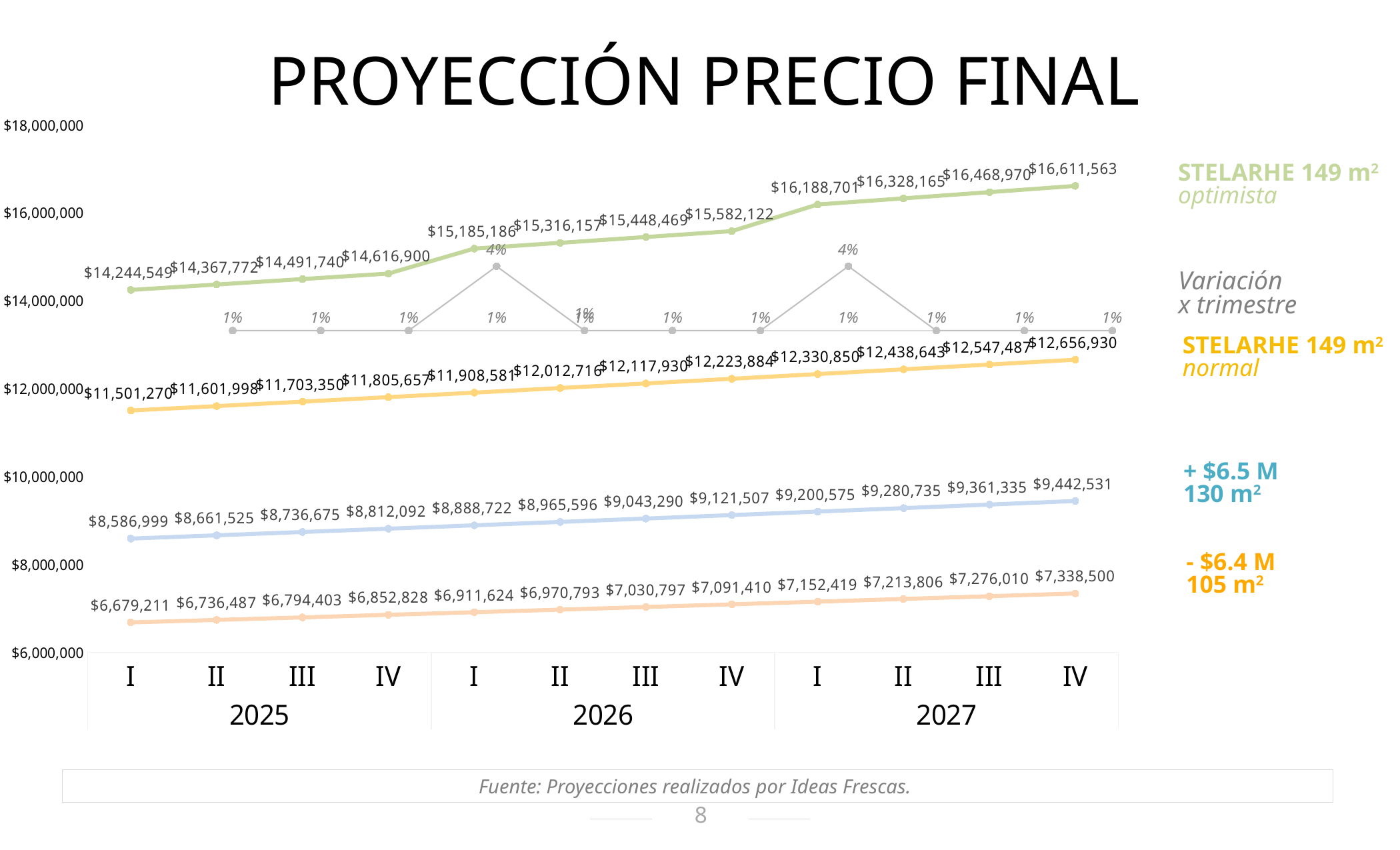
What is the title of the chart? PROYECCIÓN PRECIO FINAL Does the STELARHE 149 m² optimista series rise or fall from 2025 to 2027? rise What is the value of the 105 m² series in quarter IV of 2027? $7,338,500 How many quarters are plotted along the x axis? 12 What kind of chart is shown on the slide? line chart What is the Variación x trimestre value in quarter I of 2026? 4% In quarter IV of 2027, which is larger: the STELARHE 149 m² normal value or the 130 m² value? STELARHE 149 m² normal What is the value of the STELARHE 149 m² optimista series in quarter I of 2025? $14,244,549 What is the value of the 130 m² series in quarter I of 2025? $8,586,999 Which price series has the highest values across the chart? STELARHE 149 m² optimista What is the difference between the STELARHE 149 m² optimista value in quarter IV of 2027 and in quarter I of 2025? $2,367,014 What is the value of the STELARHE 149 m² normal series in quarter IV of 2027? $12,656,930